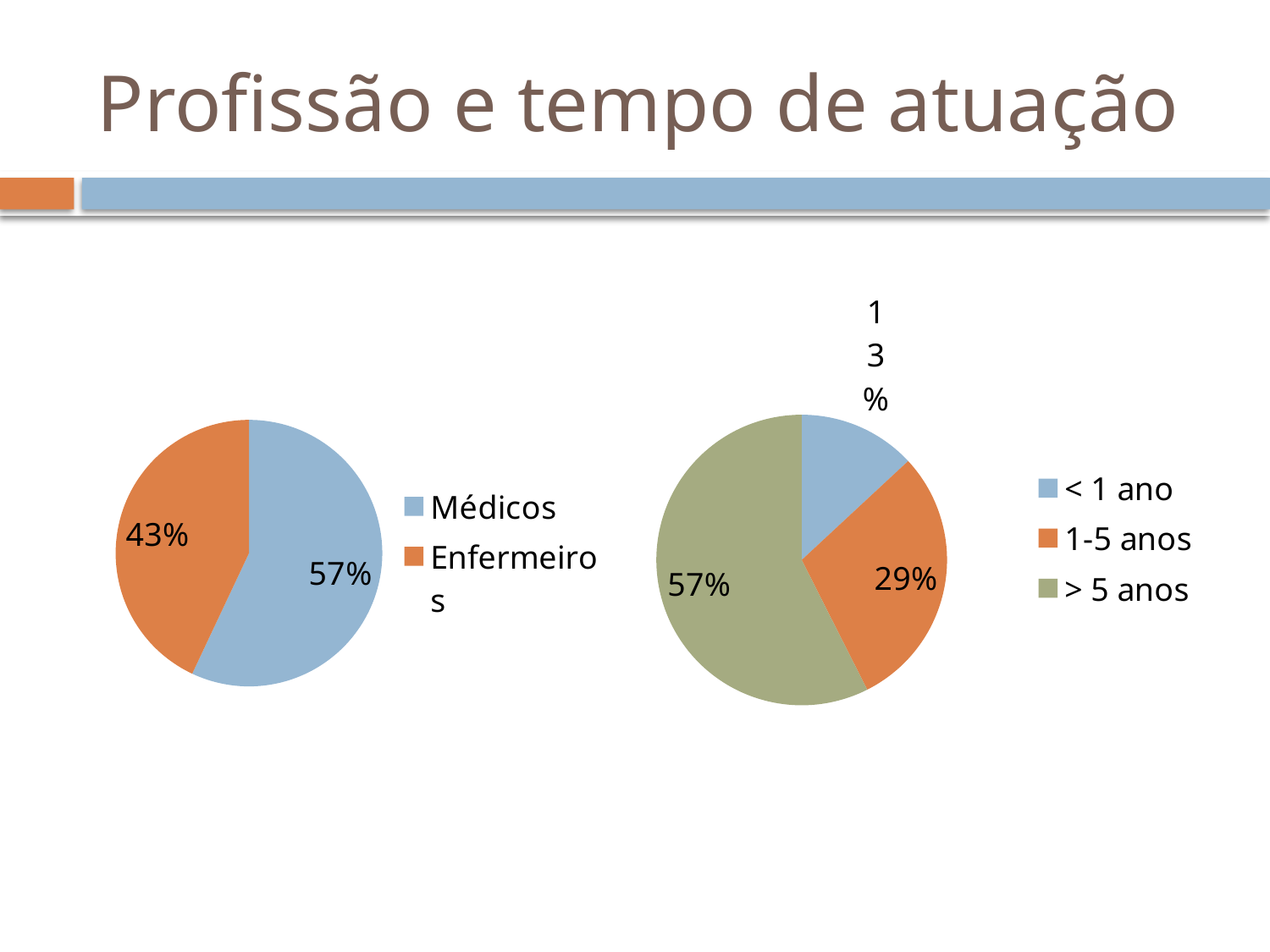
In the right pie chart, what share is labelled for 1-5 anos? 29% In the right pie chart, which is larger, 1-5 anos or < 1 ano? 1-5 anos In the left pie chart, how many slices are there? 2 In the right pie chart, how many categories does the legend list? 3 In the left pie chart, which category has the larger slice? Médicos What kind of chart is the chart on the left of the slide? Pie chart In the right pie chart, what share is labelled for > 5 anos? 57% In the left pie chart, what share is labelled for Médicos? 57% In the right pie chart, which category has the smallest slice? < 1 ano In the left pie chart, what share is labelled for Enfermeiros? 43% In the left pie chart, what is the difference in percentage points between Médicos and Enfermeiros? 14 In the right pie chart, what share is labelled for < 1 ano? 13%